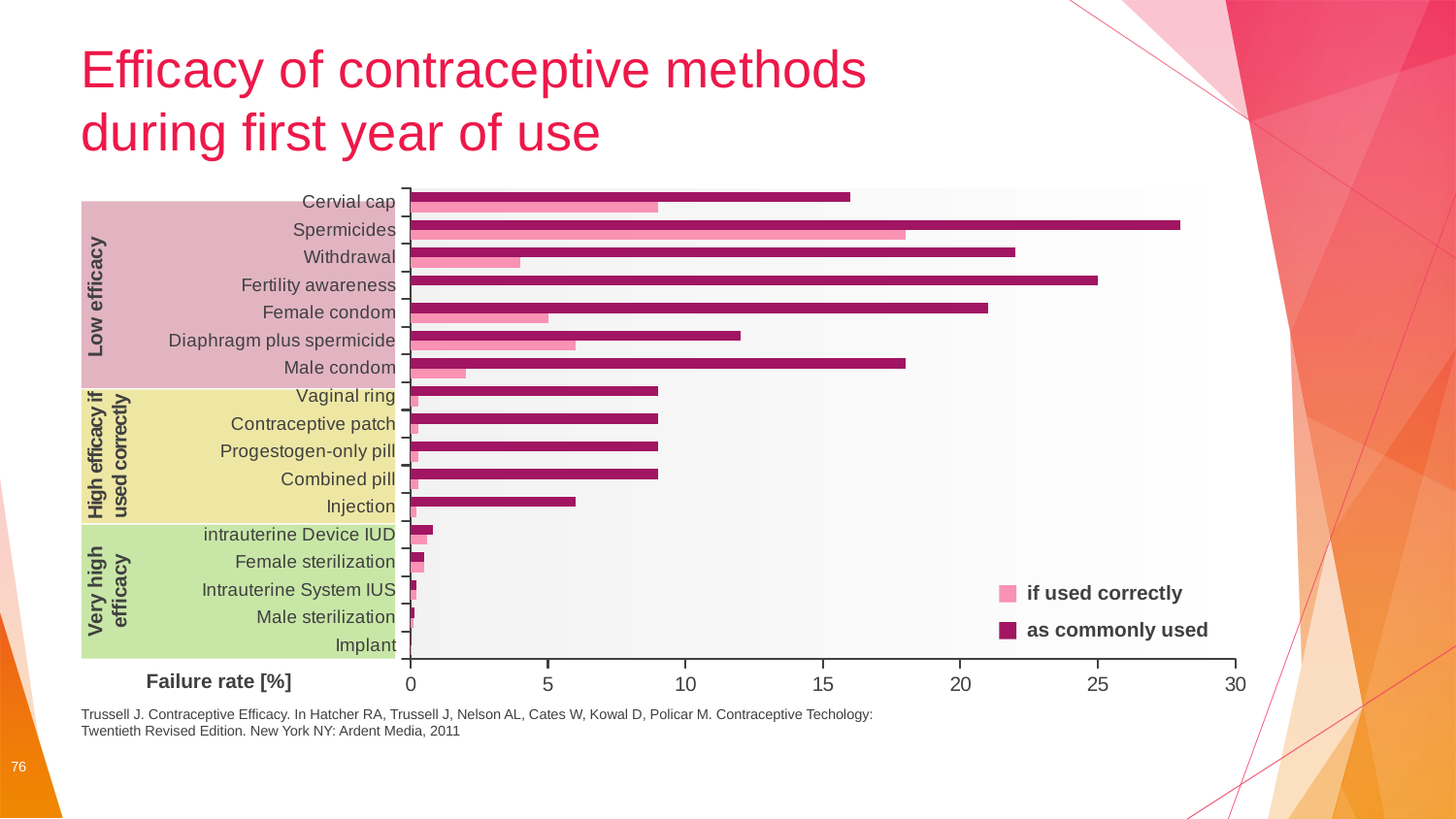
Which method has the highest failure rate 'as commonly used'? Spermicides Is the 'if used correctly' failure rate for Withdrawal greater or less than 5? less What is the label of the horizontal axis? Failure rate [%] Is the 'as commonly used' failure rate for Vaginal ring greater or less than 10? less Is the 'as commonly used' failure rate for Spermicides greater or less than 25? greater Which series is shown in the darker magenta colour? as commonly used What kind of chart is shown on the slide? bar chart How many contraceptive methods are listed on the chart? 17 How many series does the legend list? 2 Which has the larger 'as commonly used' failure rate, Male condom or Diaphragm plus spermicide? Male condom